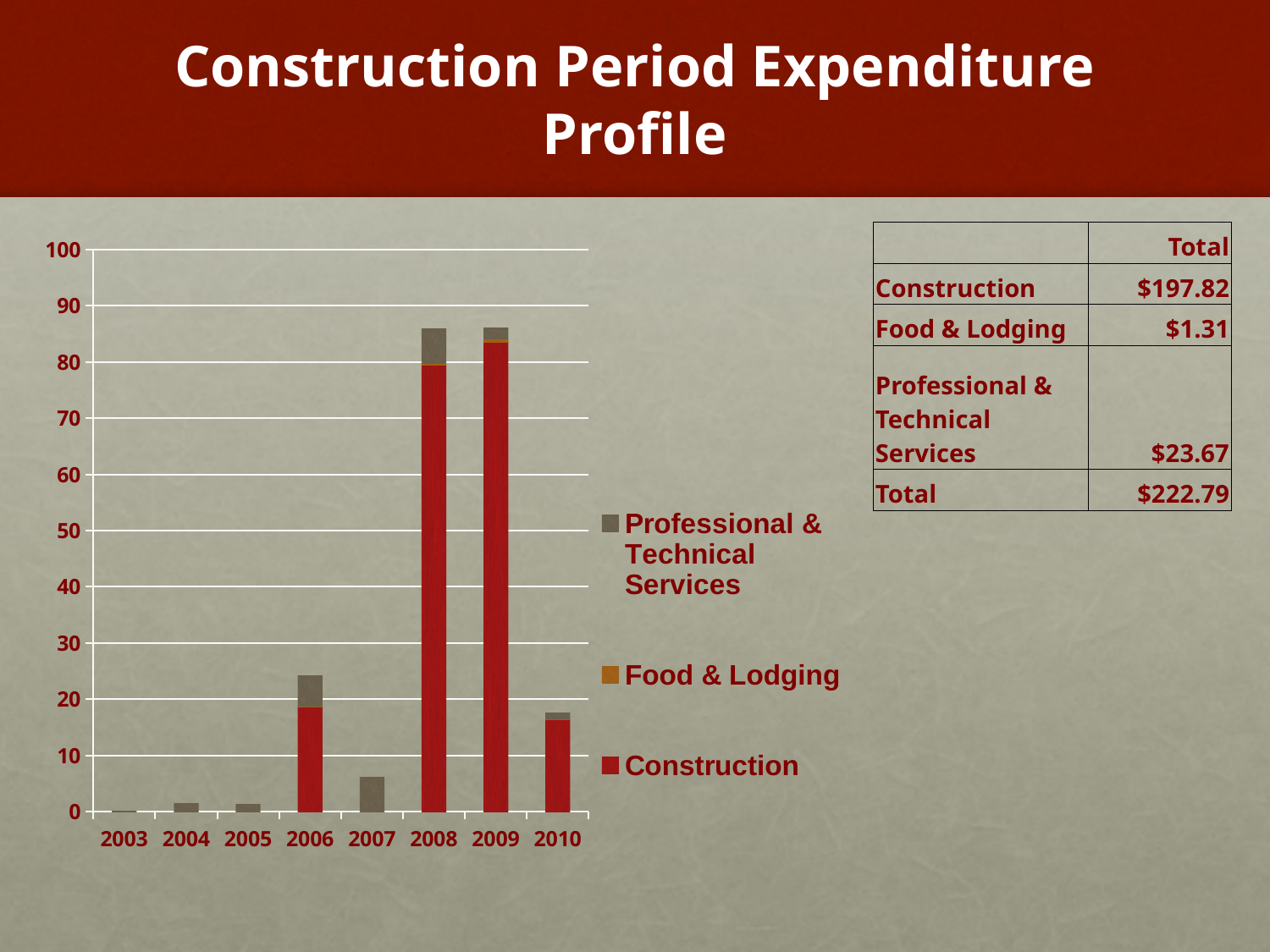
Which year has the taller total bar, 2007 or 2008? 2008 Is the total bar for 2007 greater or less than 10? less Which year has the taller total bar, 2006 or 2010? 2006 Is the total bar for 2006 greater or less than 20? greater Is the total bar for 2010 greater or less than 20? less Which series is shown in red in the chart? Construction Which year has the lowest total bar in the chart? 2003 What is the title of the slide containing the chart? Construction Period Expenditure Profile How many years are shown on the x axis of the chart? 8 What kind of chart is shown on the slide? Stacked bar chart How many series does the chart legend list? 3